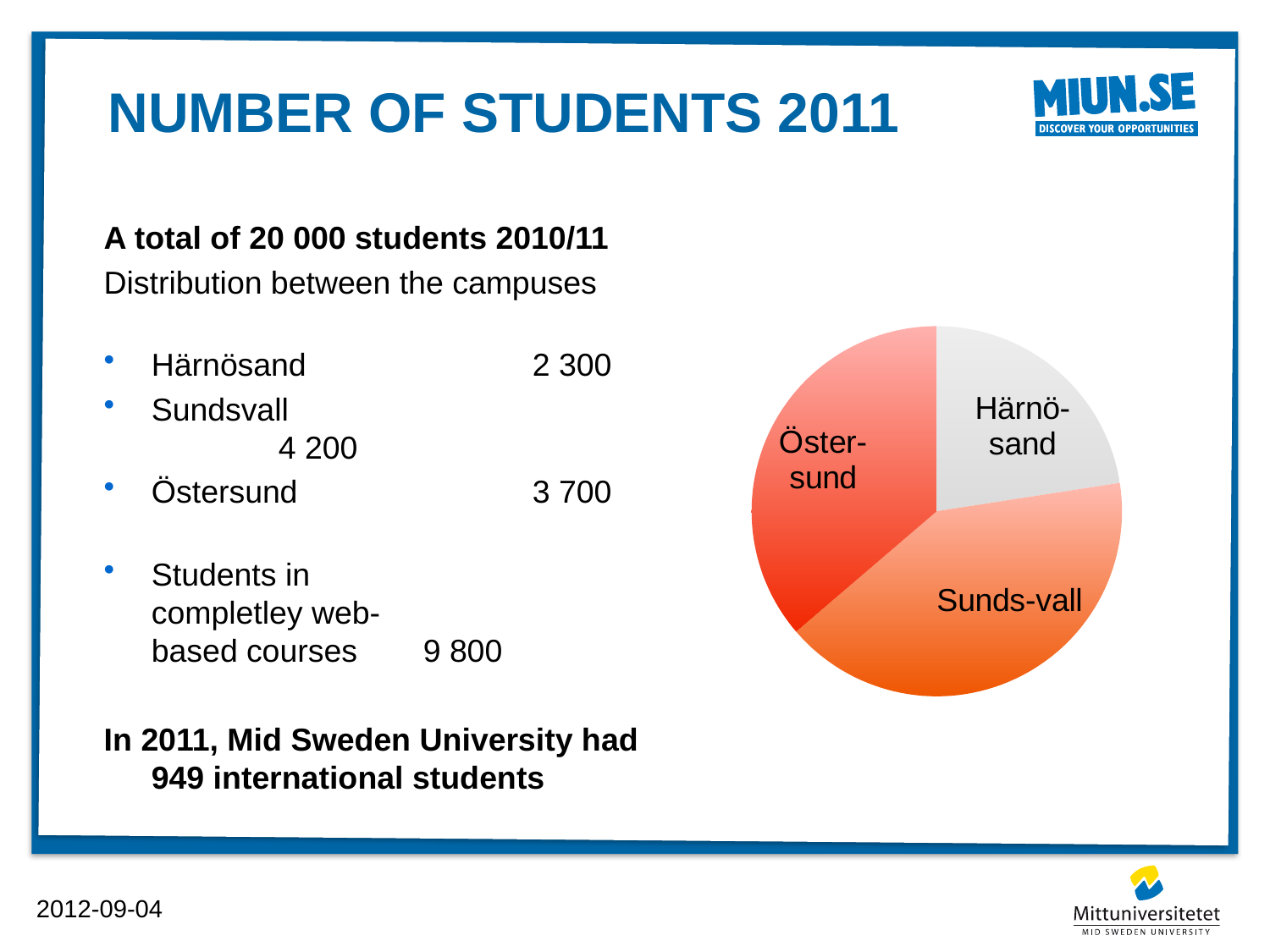
What kind of chart is shown on the slide? Pie chart Which campus has the largest slice of the pie chart? Sundsvall What is the difference in student numbers between Sundsvall and Härnösand? 1 900 What colour is the Härnösand slice of the pie chart? Grey What is the difference in student numbers between Östersund and Härnösand? 1 400 How many students does the slide give for Sundsvall? 4 200 How many campuses (slices) does the pie chart show? 3 Which slice is larger, Östersund or Härnösand? Östersund How many students does the slide give for Härnösand? 2 300 What is the difference in student numbers between Sundsvall and Östersund? 500 Which campus has the smallest slice of the pie chart? Härnösand How many students does the slide give for Östersund? 3 700